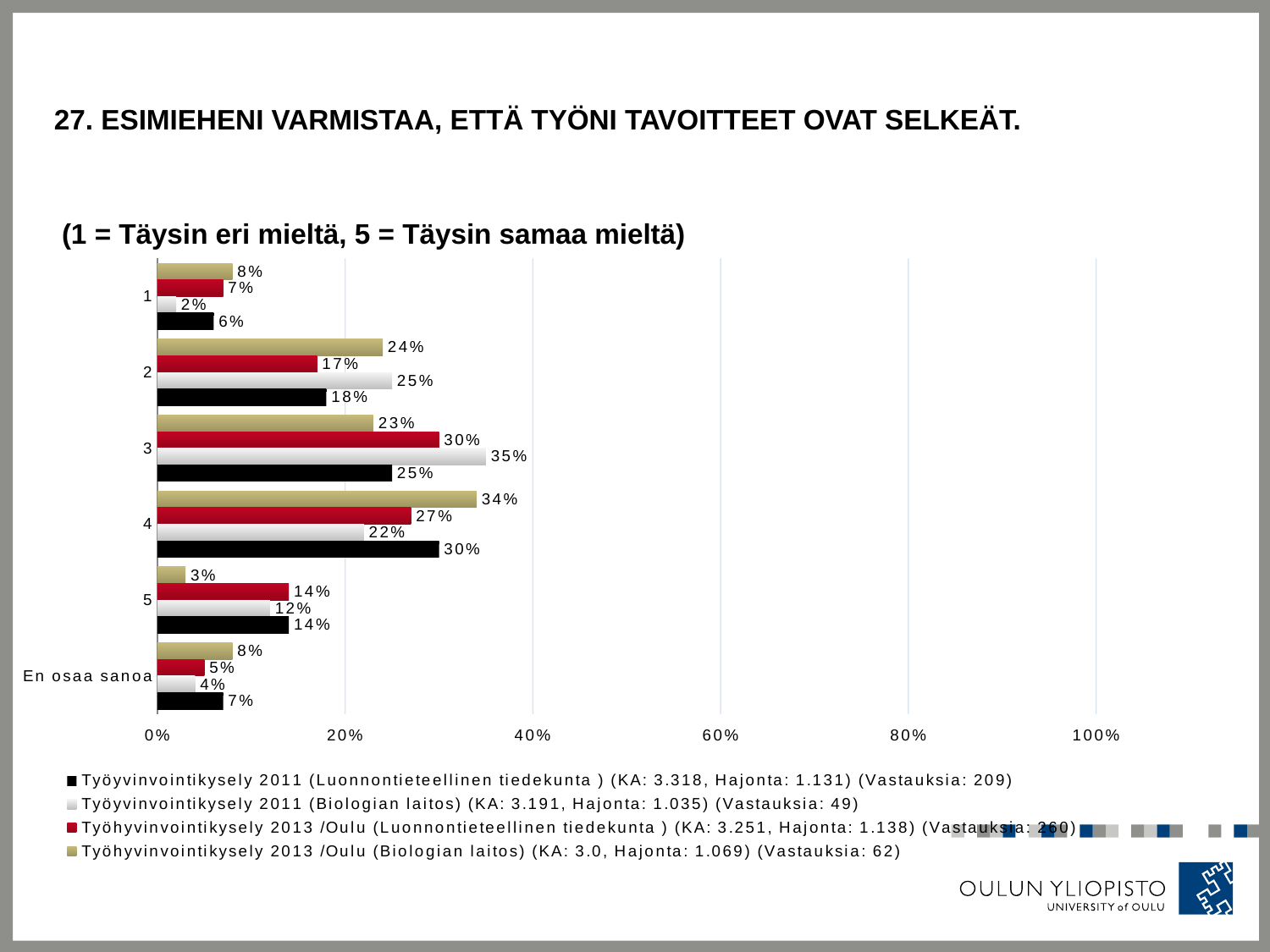
Which category has the lowest value in the Työyvinvointikysely 2011 (Biologian laitos) series? 1 What is the value for 'En osaa sanoa' in the Työyvinvointikysely 2011 (Luonnontieteellinen tiedekunta) series? 7% Is the value for category 4 in the Työyvinvointikysely 2011 (Luonnontieteellinen tiedekunta) series greater or less than 20%? greater How many categories are shown on the vertical axis? 6 How many series does the legend list? 4 What is the value for category 4 in the Työhyvinvointikysely 2013 /Oulu (Biologian laitos) series? 34% What is the value for category 3 in the Työyvinvointikysely 2011 (Biologian laitos) series? 35% What is the highest value shown on the horizontal axis? 100% For category 5, which is larger: the Työhyvinvointikysely 2013 /Oulu (Luonnontieteellinen tiedekunta) value or the Työhyvinvointikysely 2013 /Oulu (Biologian laitos) value? Työhyvinvointikysely 2013 /Oulu (Luonnontieteellinen tiedekunta) What is the difference between the Työyvinvointikysely 2011 (Biologian laitos) value and the Työhyvinvointikysely 2013 /Oulu (Biologian laitos) value for category 3? 12% Which category has the highest value in the Työhyvinvointikysely 2013 /Oulu (Luonnontieteellinen tiedekunta) series? 3 What type of chart is shown on the slide? bar chart